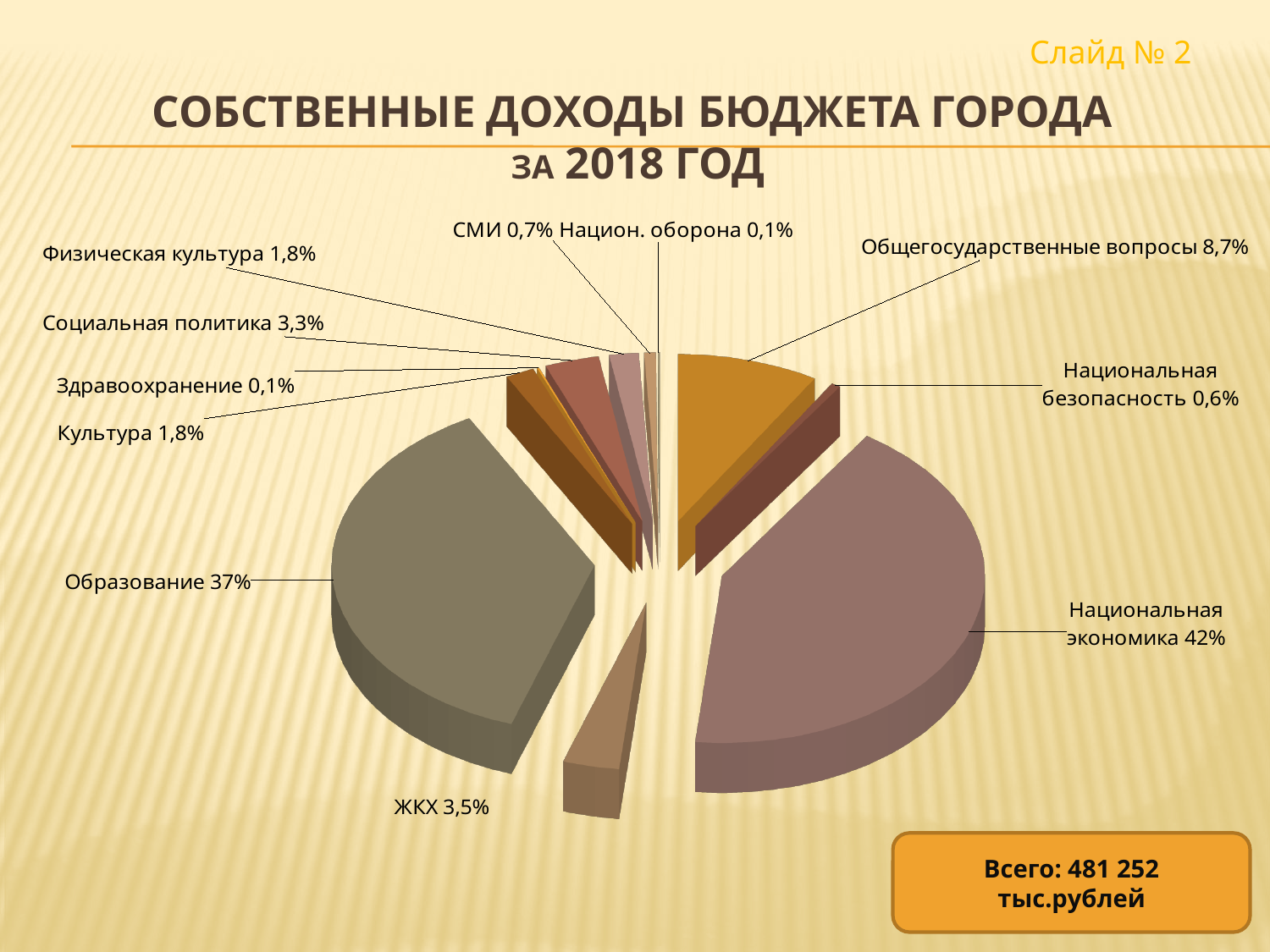
What is the value for ЖКХ? 3,5% What percentage is labelled for Общегосударственные вопросы? 8,7% What kind of chart is shown on the slide? pie chart Which category has the largest slice of the pie? Национальная экономика What total amount is stated in the box at the bottom right of the slide? 481 252 тыс.рублей What share of the pie does Образование have? 37% What share is shown for Социальная политика? 3,3% What is the value shown for Национальная экономика? 42% What is the difference in percentage points between Национальная экономика and Образование? 5% How many categories are shown in the pie chart? 11 Which is larger, the share for Общегосударственные вопросы or the share for ЖКХ? Общегосударственные вопросы What is the value labelled for Национальная безопасность? 0,6%